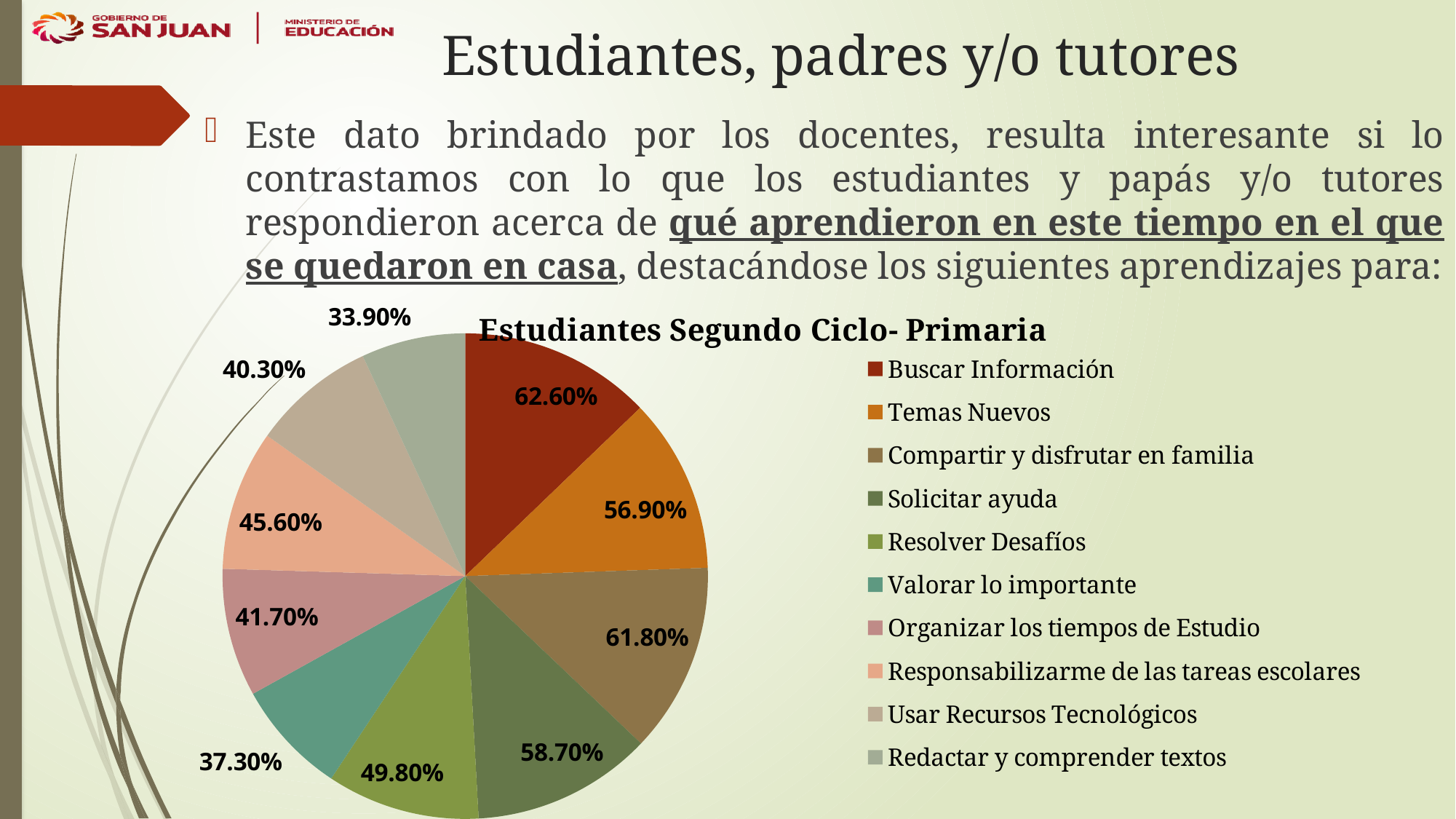
Which category has the lowest value in the pie chart? Redactar y comprender textos Which category has the highest value in the pie chart? Buscar Información What is the title of the pie chart? Estudiantes Segundo Ciclo- Primaria Which has a larger value, Solicitar ayuda or Valorar lo importante? Solicitar ayuda How many categories does the pie chart's legend list? 10 What is the difference between the values for Buscar Información and Compartir y disfrutar en familia? 0.80% What is the value shown for Temas Nuevos? 56.90% What is the value shown for Redactar y comprender textos? 33.90% What is the difference between the values for Responsabilizarme de las tareas escolares and Usar Recursos Tecnológicos? 5.30% What is the value shown for Resolver Desafíos? 49.80% What type of chart is shown on the slide? pie chart What is the value shown for Buscar Información? 62.60%